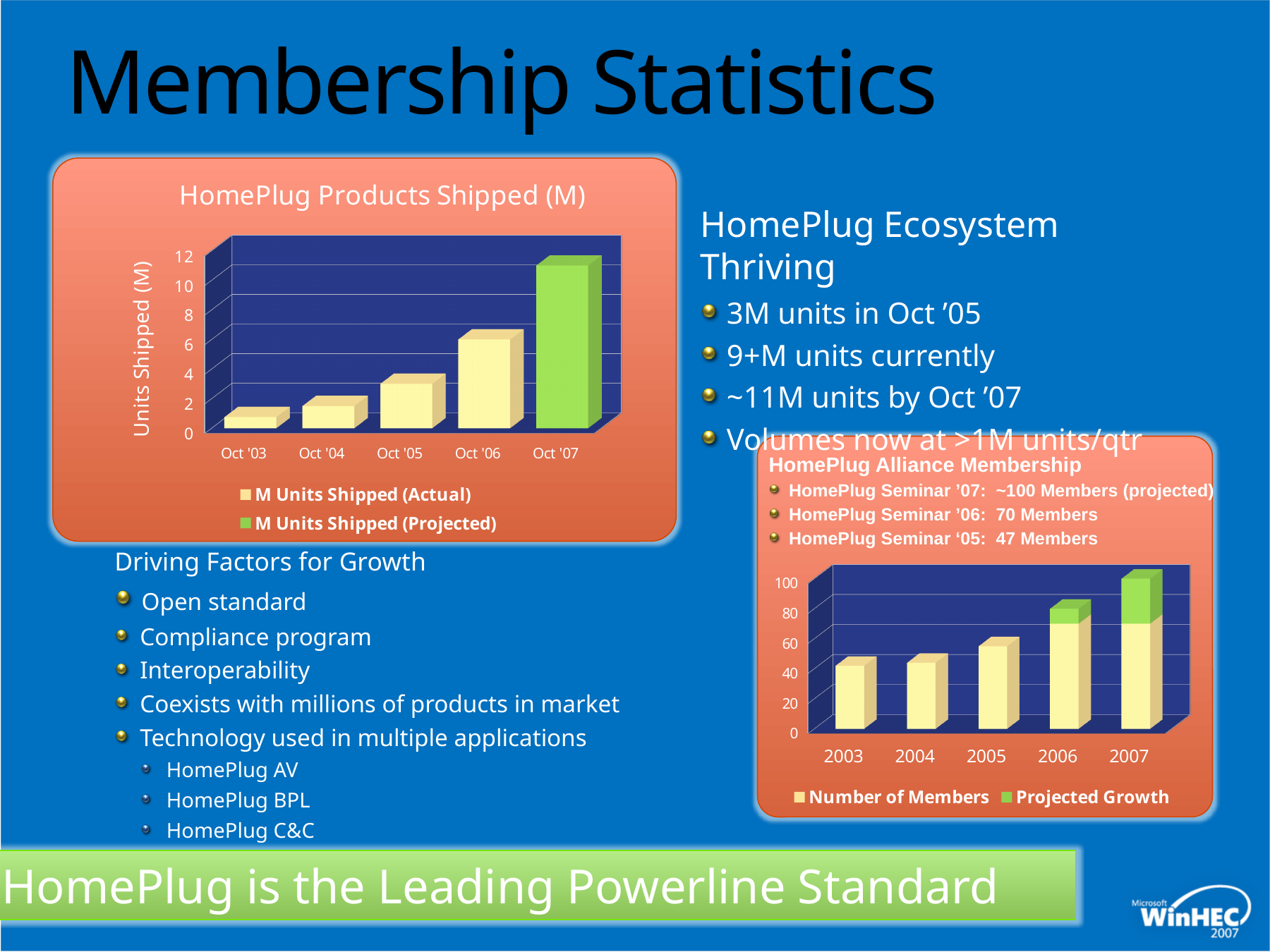
In the 'HomePlug Products Shipped (M)' chart, is the value for Oct '03 greater or less than 2? less In the 'HomePlug Products Shipped (M)' chart, is the value for Oct '07 greater or less than 10? greater In the 'HomePlug Products Shipped (M)' chart, what is the label of the y axis? Units Shipped (M) In the 'HomePlug Products Shipped (M)' chart, which category has the lowest value? Oct '03 In the 'HomePlug Products Shipped (M)' chart, how many series does the legend list? 2 In the 'HomePlug Alliance Membership' chart on the right, is the total bar height for 2007 greater or less than 80? greater In the 'HomePlug Alliance Membership' chart on the right, how many series does the legend list? 2 What kind of chart is the 'HomePlug Products Shipped (M)' chart? bar chart In the 'HomePlug Alliance Membership' chart on the right, which year has the tallest bar? 2007 In the 'HomePlug Products Shipped (M)' chart, do the values rise or fall from Oct '03 to Oct '07? rise In the 'HomePlug Products Shipped (M)' chart, which category has the highest value? Oct '07 In the 'HomePlug Products Shipped (M)' chart, how many categories are shown on the x axis? 5